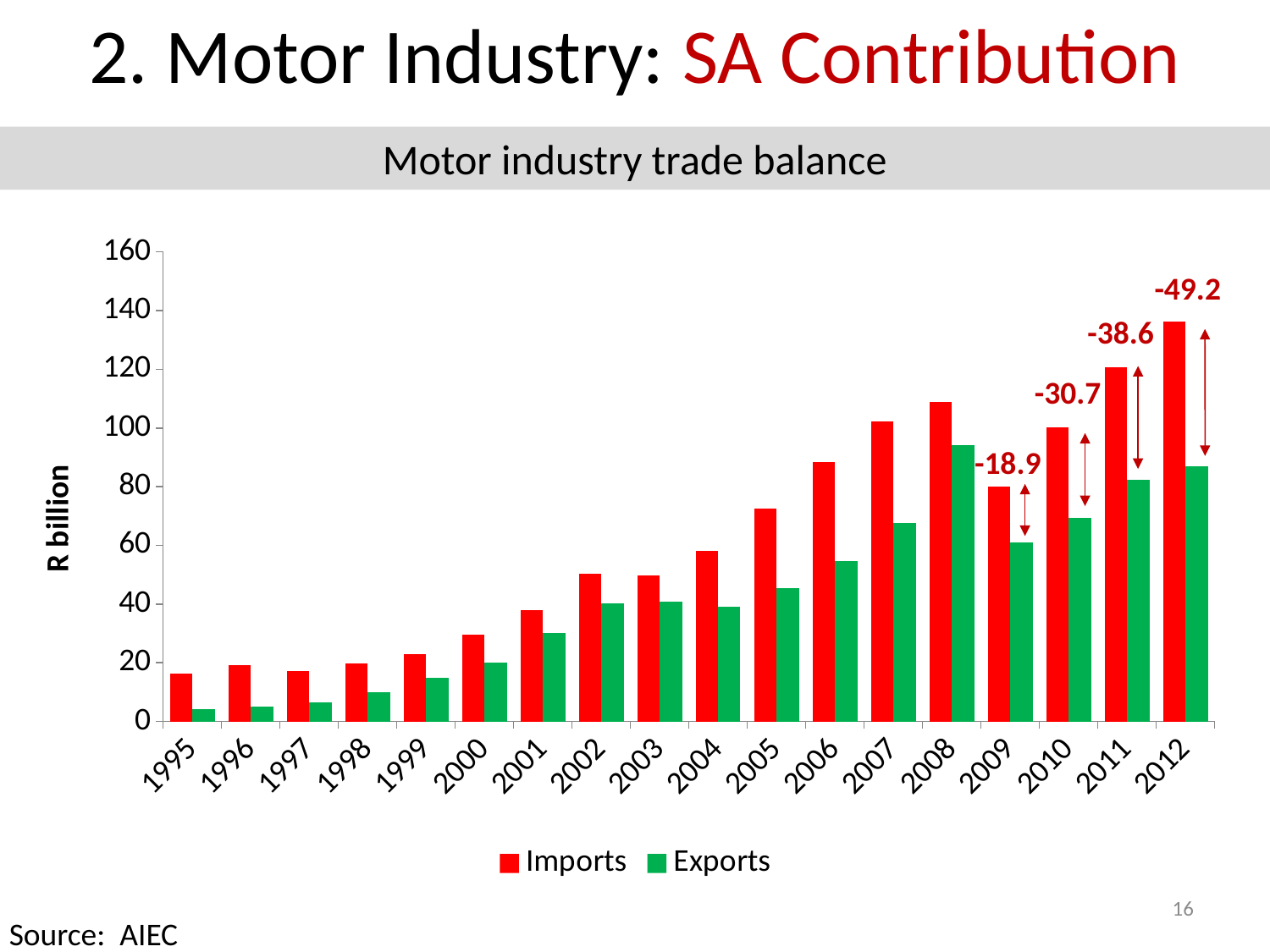
What trade balance figure is annotated for 2009? -18.9 Do Imports generally rise or fall from 1995 to 2012? Rise What is the label on the y axis? R billion In which year are Imports highest? 2012 What kind of chart is shown on the slide? Bar chart How many series does the legend list? 2 Is the value for Imports in 2012 greater or less than 120? greater Which is larger in 2008, Imports or Exports? Imports In which year are Exports lowest? 1995 What trade balance figure is annotated for 2012? -49.2 How many years are shown on the x axis? 18 Is the value for Imports in 1995 greater or less than 20? less